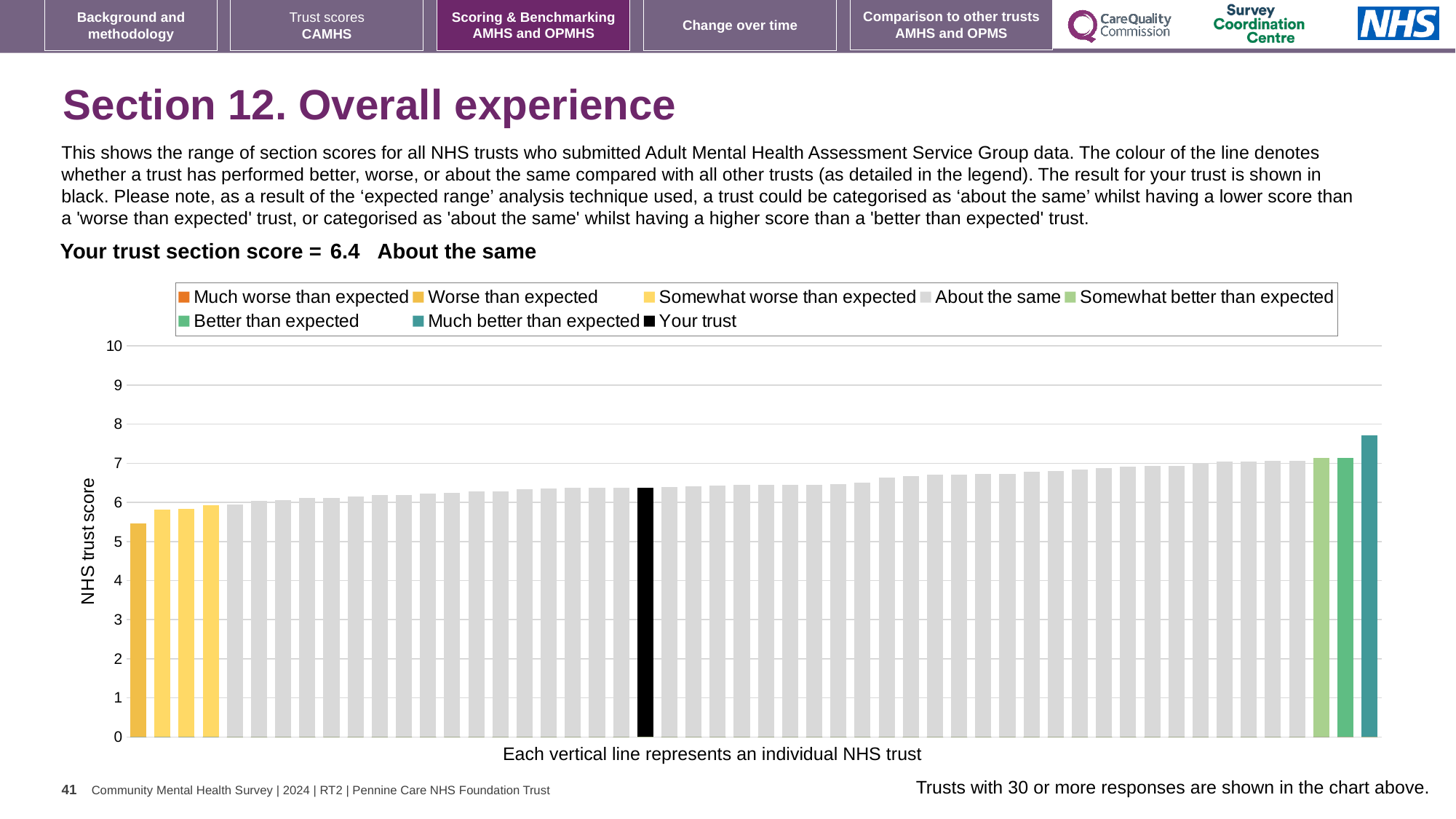
Which category is your trust's section score placed in? About the same What is the section score for your trust shown on the slide? 6.4 What kind of chart is shown on the slide? bar chart Is the value of the leftmost (lowest) bar greater or less than 6? less Is the value of the rightmost (highest) bar greater or less than 7? greater What is the label on the vertical axis of the chart? NHS trust score How many bars are coloured teal (Much better than expected)? 1 Is the value of the tallest bar greater or less than 8? less Do the bar values rise or fall from left to right across the chart? rise How many entries does the chart legend list? 8 What is the highest tick value shown on the vertical axis? 10